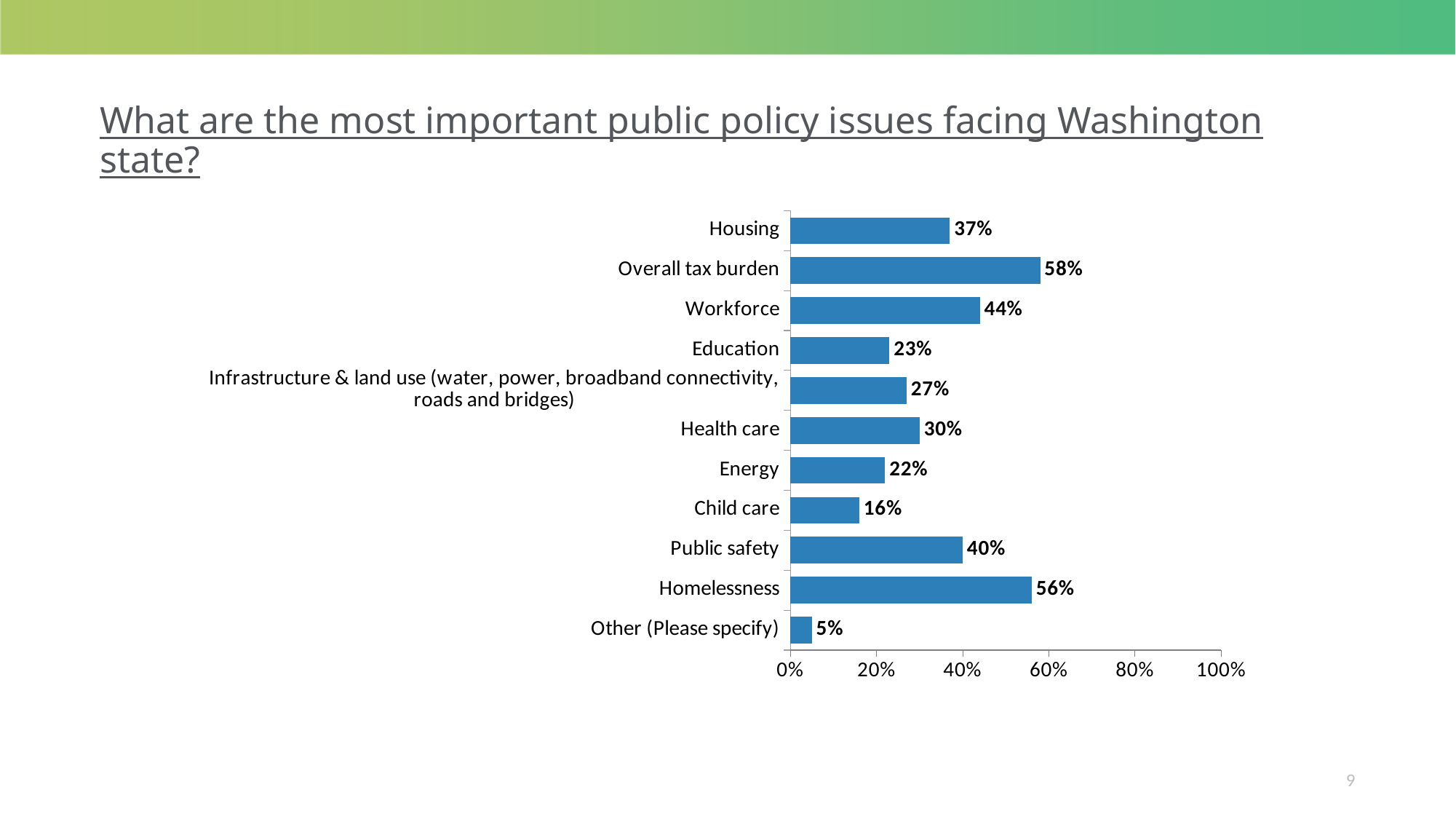
What is the value for Child care? 16% How many categories are shown in the chart? 11 What is the difference between the values for Workforce and Education? 21% Which is larger, the value for Health care or the value for Energy? Health care What is the value for Homelessness? 56% What is the difference between the values for Public safety and Housing? 3% What is the title of the slide? What are the most important public policy issues facing Washington state? Which category has the highest value? Overall tax burden Which category has the lowest value? Other (Please specify) What is the value for Infrastructure & land use (water, power, broadband connectivity, roads and bridges)? 27% What is the value for Overall tax burden? 58% What kind of chart is shown on the slide? Bar chart